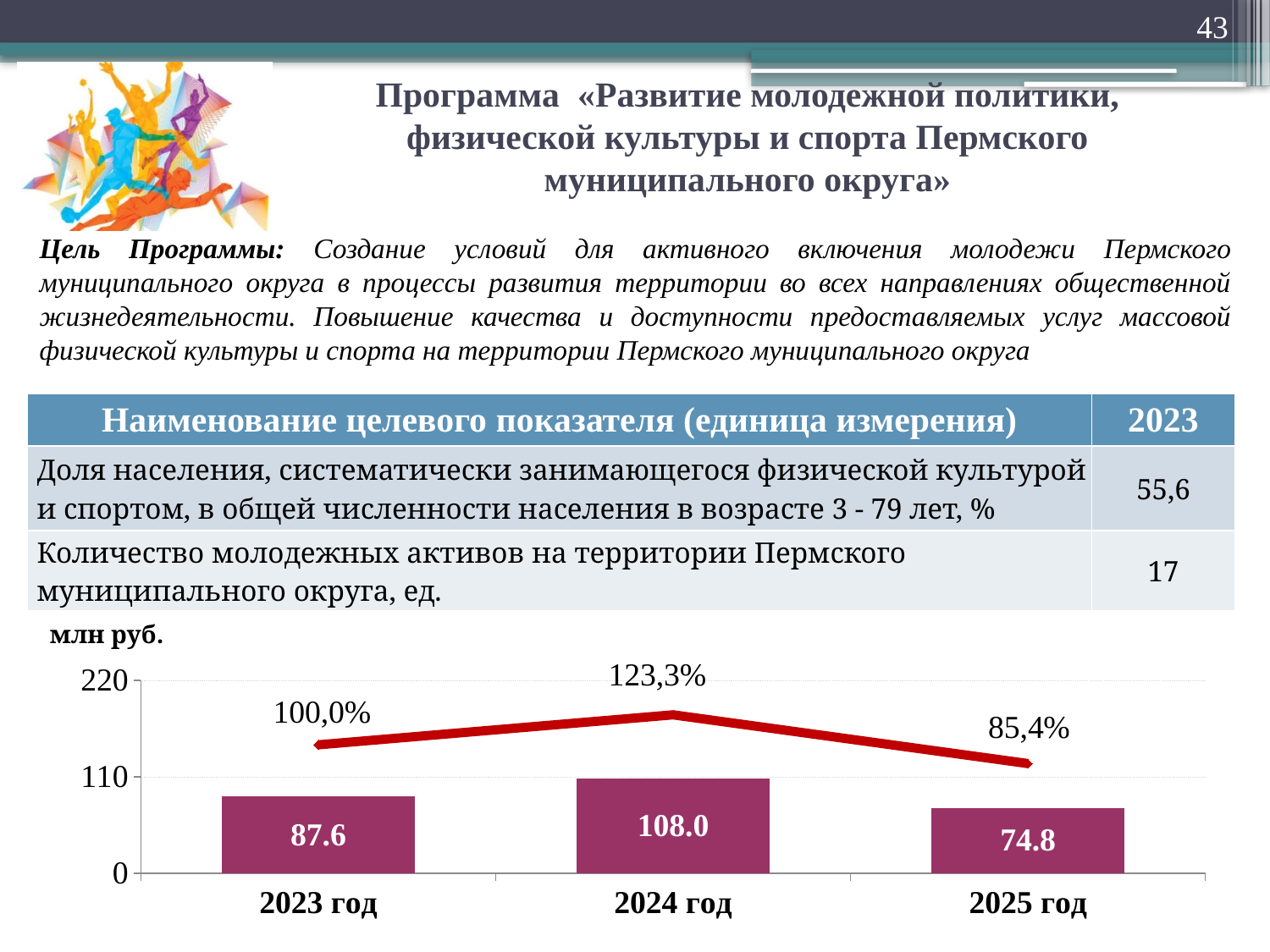
What is the value for 2023 год in the bar chart? 87.6 Which year has the highest bar in the chart? 2024 год Is the value for 2023 год greater or less than 110? less What kind of chart is shown on the slide? combination bar and line chart What percentage label is shown on the line above 2024 год? 123,3% What is the difference between the values for 2024 год and 2025 год? 33.2 Which year has the lowest bar in the chart? 2025 год Which is larger, the value for 2023 год or the value for 2025 год? 2023 год How many years are shown on the x axis of the chart? 3 What is the value for 2024 год in the bar chart? 108.0 What unit is indicated above the chart? млн руб. What is the value for 2025 год in the bar chart? 74.8